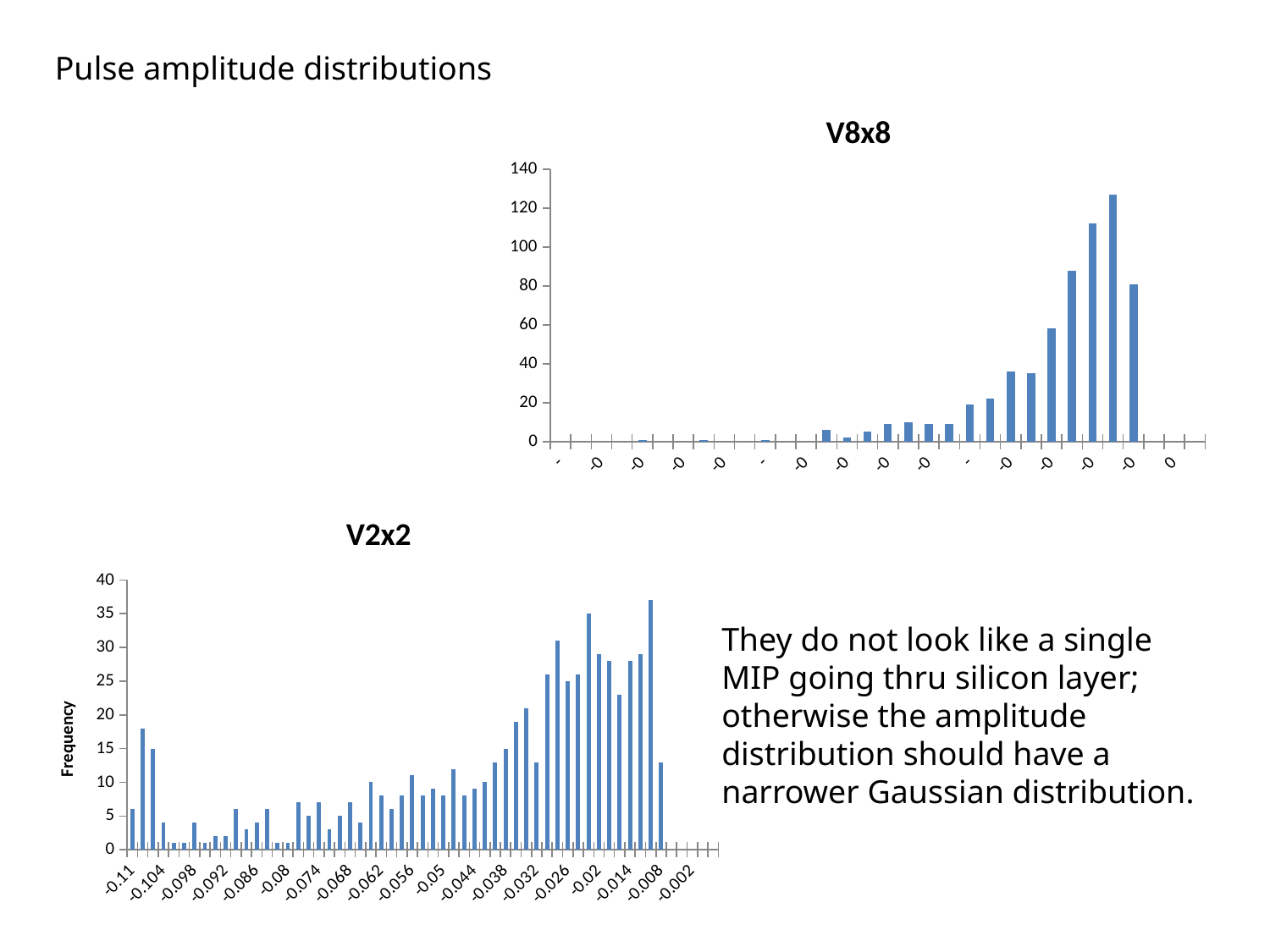
What is the y-axis label on the V2x2 chart? Frequency Which chart has the taller maximum bar, V8x8 or V2x2? V8x8 What kind of chart is the V2x2 chart? bar chart In the V2x2 chart, is the value of the tallest bar greater or less than 35? greater In the V8x8 chart, do the bar heights generally rise or fall when moving from left to right across most of the x axis? rise What kind of chart is the V8x8 chart? bar chart What is the title of the chart in the top right of the slide? V8x8 In the V8x8 chart, is the value of the tallest bar greater or less than 120? greater In the V2x2 chart, is the value of the first bar at -0.11 greater or less than 10? less